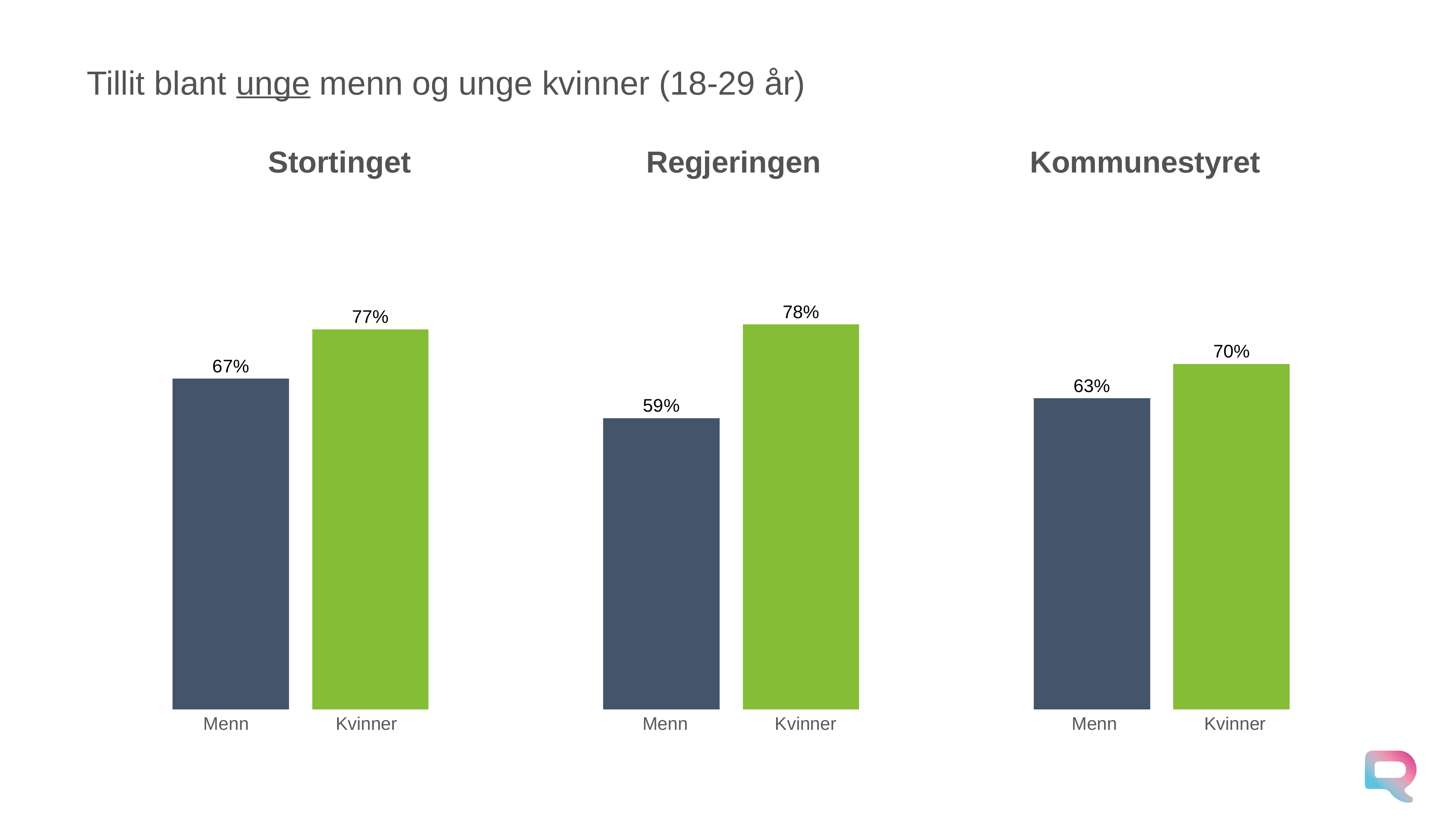
What kind of chart is the Kommunestyret chart? Bar chart In the Regjeringen chart, which category has the lowest value? Menn How many bars are shown in the Stortinget chart? 2 In the Regjeringen chart, what is the value for Menn? 59% In the Kommunestyret chart, which category has the higher value, Menn or Kvinner? Kvinner In the Stortinget chart, what is the difference between the values for Kvinner and Menn? 10 percentage points In the Kommunestyret chart, what is the value for Menn? 63% In the Kommunestyret chart, what is the value for Kvinner? 70% In the Regjeringen chart, what is the difference between the values for Kvinner and Menn? 19 percentage points In the Stortinget chart, what is the value for Kvinner? 77% In the Stortinget chart, what is the value for Menn? 67% In the Regjeringen chart, what is the value for Kvinner? 78%